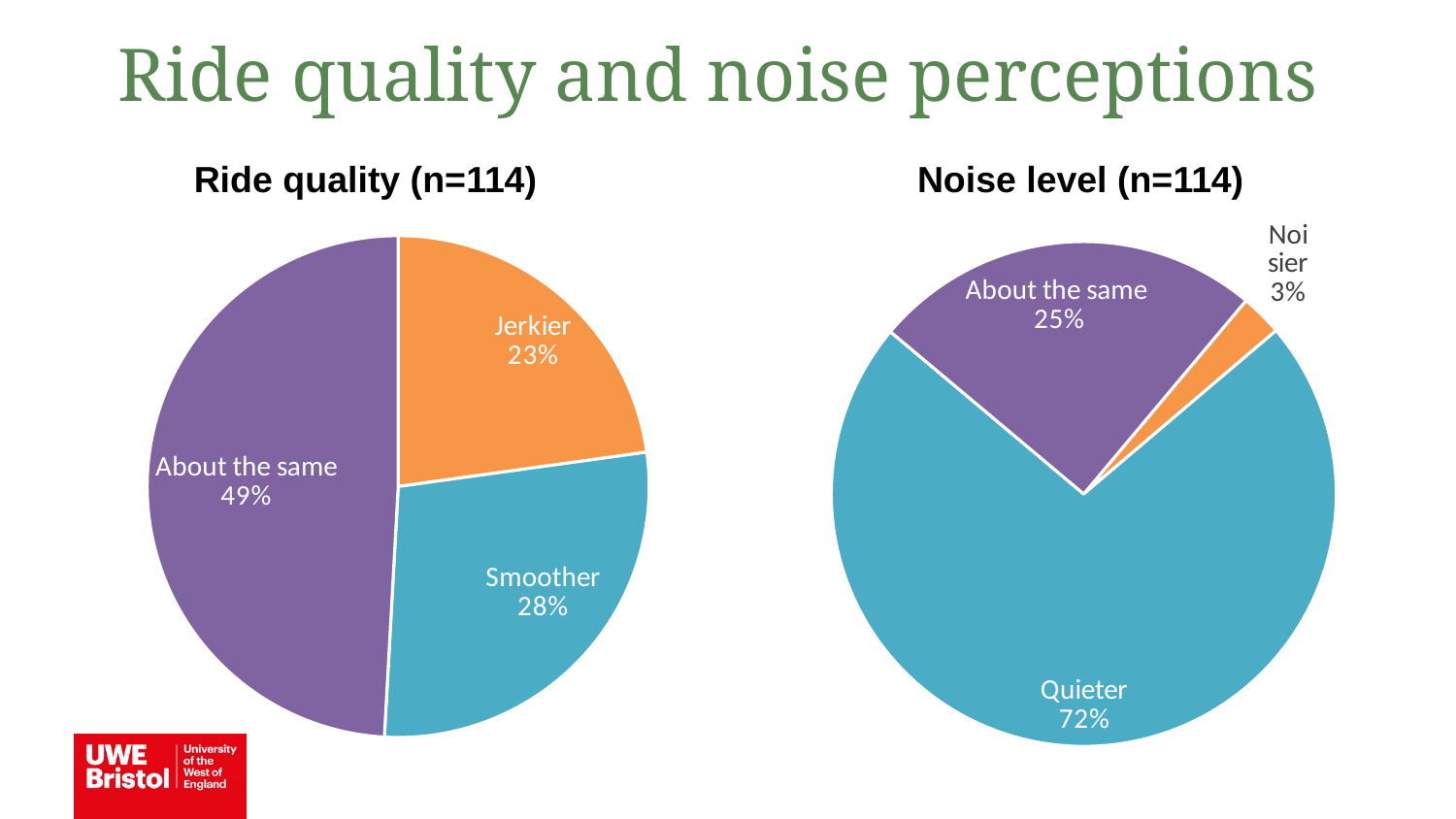
What type of chart is the Noise level (n=114) chart? Pie chart In the Noise level (n=114) chart, what percentage of respondents said it was Noisier? 3% In the Ride quality (n=114) chart, what percentage of respondents said the ride was Smoother? 28% In the Ride quality (n=114) chart, what is the difference in percentage points between About the same and Smoother? 21 In the Noise level (n=114) chart, which is larger: About the same or Noisier? About the same In the Ride quality (n=114) chart, which category has the largest share? About the same In the Ride quality (n=114) chart, which category has the smallest share? Jerkier How many categories does the Ride quality (n=114) chart show? 3 In the Noise level (n=114) chart, what is the difference in percentage points between Quieter and About the same? 47 In the Noise level (n=114) chart, which category has the smallest share? Noisier In the Ride quality (n=114) chart, what percentage of respondents said the ride was Jerkier? 23% In the Noise level (n=114) chart, what percentage of respondents said it was Quieter? 72%